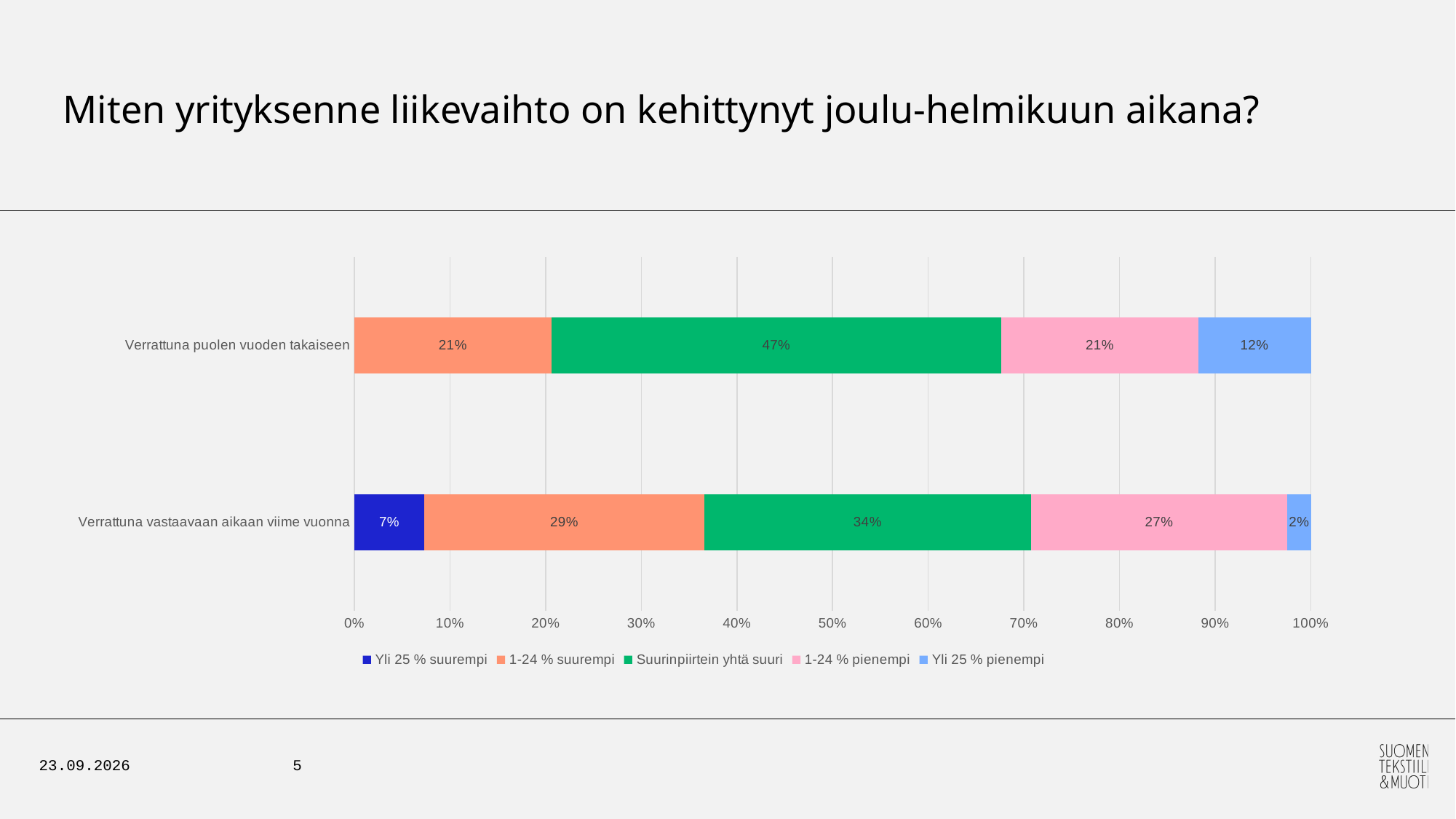
Which segment is the smallest in the 'Verrattuna vastaavaan aikaan viime vuonna' bar? Yli 25 % pienempi How many series does the legend list? 5 What is the value of 'Yli 25 % pienempi' for 'Verrattuna puolen vuoden takaiseen'? 12% What is the title of the slide? Miten yrityksenne liikevaihto on kehittynyt joulu-helmikuun aikana? What is the difference between the 'Suurinpiirtein yhtä suuri' values for 'Verrattuna puolen vuoden takaiseen' and 'Verrattuna vastaavaan aikaan viime vuonna'? 13% What is the value of '1-24 % pienempi' for 'Verrattuna vastaavaan aikaan viime vuonna'? 27% Which category has the larger '1-24 % suurempi' value, 'Verrattuna puolen vuoden takaiseen' or 'Verrattuna vastaavaan aikaan viime vuonna'? Verrattuna vastaavaan aikaan viime vuonna What type of chart is shown on the slide? Stacked bar chart What is the value of 'Yli 25 % suurempi' for 'Verrattuna vastaavaan aikaan viime vuonna'? 7% What is the value of 'Suurinpiirtein yhtä suuri' for 'Verrattuna puolen vuoden takaiseen'? 47% Which segment is the largest in the 'Verrattuna vastaavaan aikaan viime vuonna' bar? Suurinpiirtein yhtä suuri How many categories (bars) does the chart show? 2